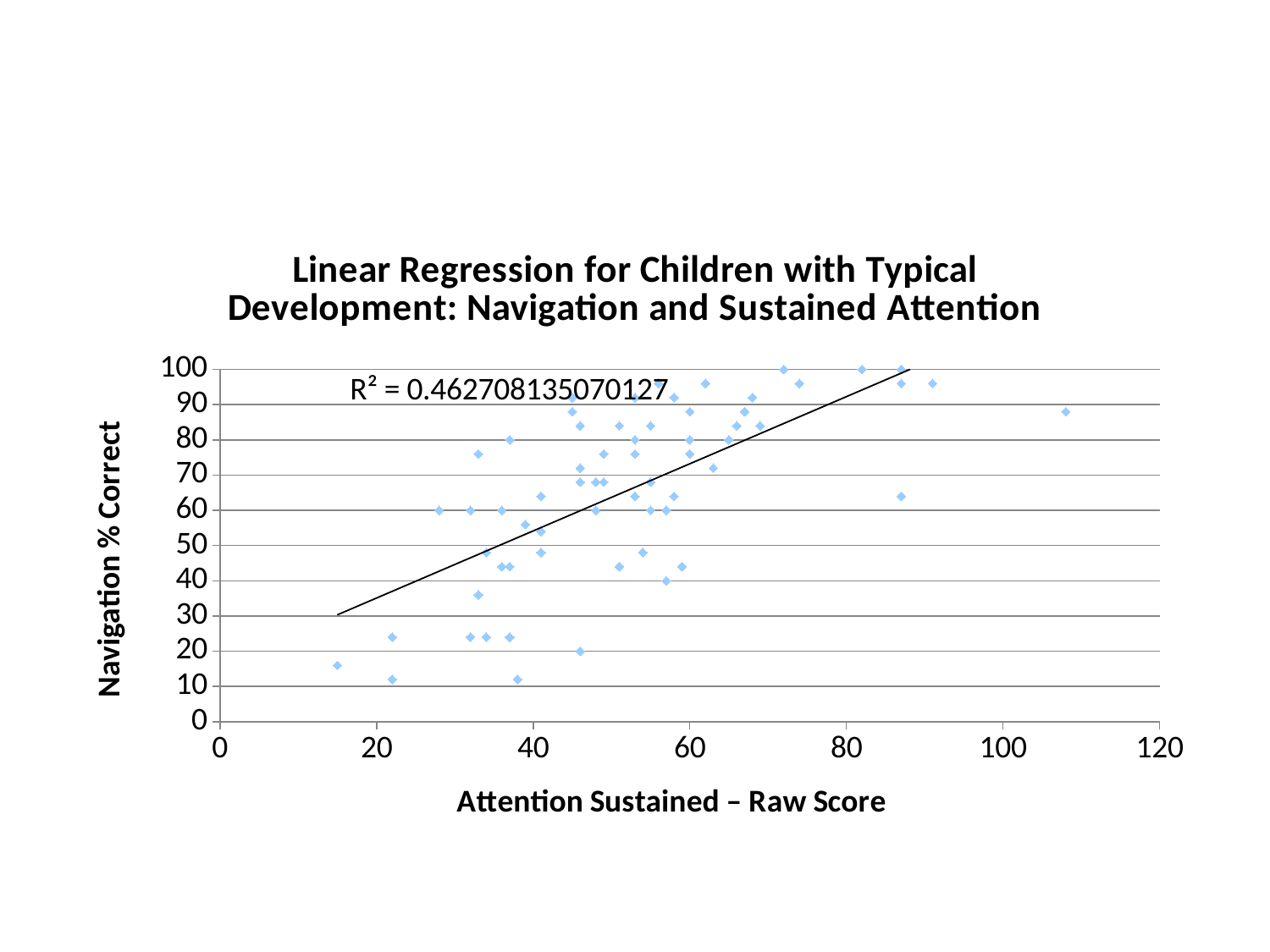
What is the highest value shown on the x axis? 120 What kind of chart is shown on the slide? scatter plot Does the trend line rise or fall as the Attention Sustained raw score increases? rise What is the title of the chart? Linear Regression for Children with Typical Development: Navigation and Sustained Attention Is the Navigation % Correct value for the leftmost point (near an Attention Sustained raw score of 15) greater or less than 20? less Is the Navigation % Correct value for the point at an Attention Sustained raw score of about 72 greater or less than 90? greater What is the highest value shown on the y axis? 100 Is the Navigation % Correct value for the rightmost point (near an Attention Sustained raw score of 108) greater or less than 80? greater What R² value is printed on the chart? R² = 0.462708135070127 What is the label of the x axis? Attention Sustained – Raw Score